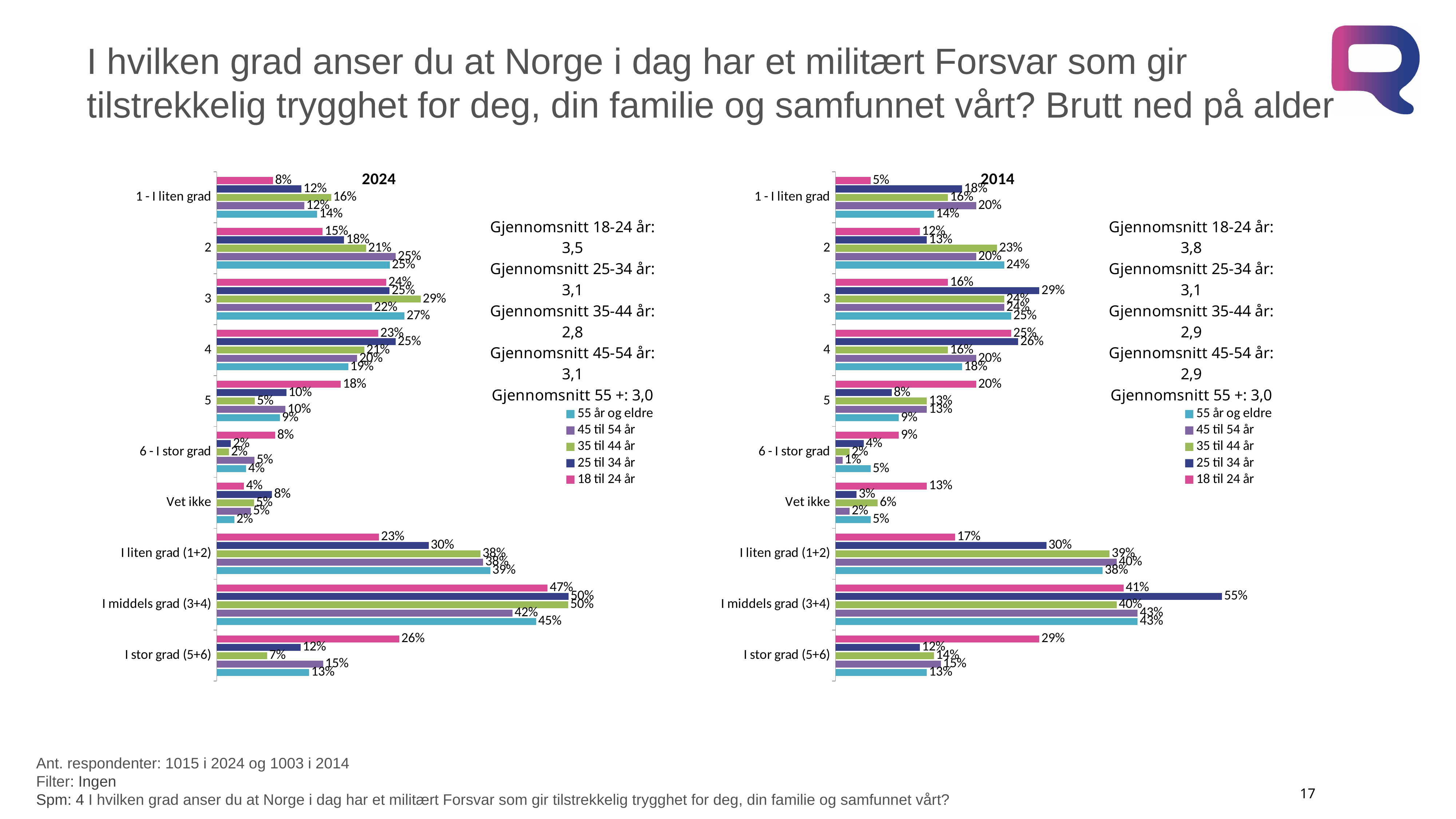
What kind of chart is the 2024 chart? Bar chart In the 2024 chart, what is the value for 18 til 24 år in the category I stor grad (5+6)? 26% In the 2024 chart, which age group has the highest value in the category I liten grad (1+2)? 55 år og eldre In the 2014 chart, what is the value for 45 til 54 år in the category 6 - I stor grad? 1% What is the title of the chart on the right side of the slide? 2014 How many series does the legend of the 2024 chart list? 5 In the 2014 chart, which is larger in the category Vet ikke: the value for 18 til 24 år or the value for 55 år og eldre? 18 til 24 år In the 2014 chart, what is the value for 25 til 34 år in the category I middels grad (3+4)? 55% In the 2014 chart, which age group has the lowest value in the category I liten grad (1+2)? 18 til 24 år In the 2024 chart, what is the difference between the 18 til 24 år value and the 35 til 44 år value in the category I stor grad (5+6)? 19% In the 2024 chart, what is the value for 35 til 44 år in the category 3? 29% How many categories are shown on the y axis of the 2014 chart? 10